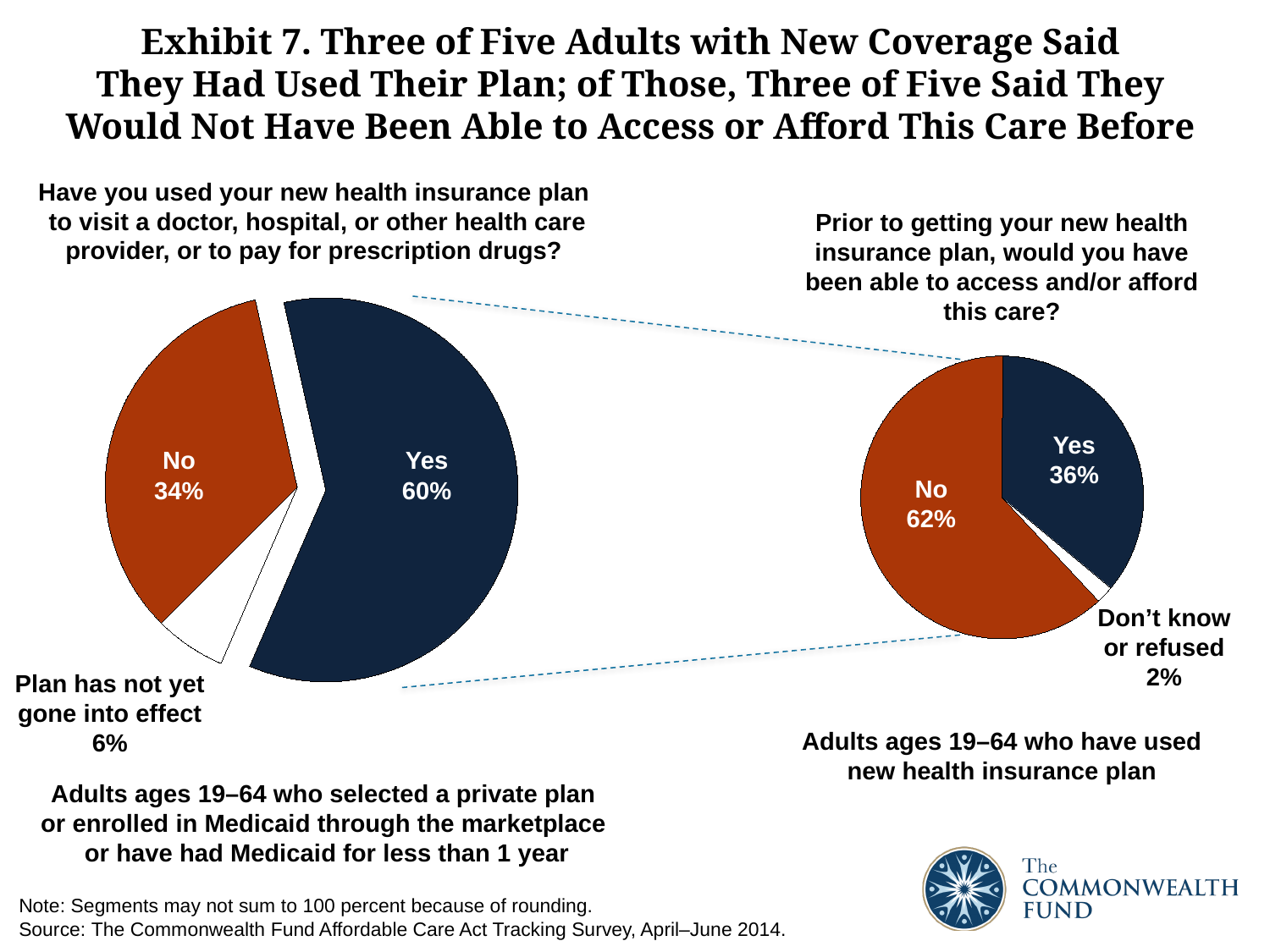
In the left pie chart (Have you used your new health insurance plan...), which segment is the smallest? Plan has not yet gone into effect In the right pie chart (Prior to getting your new health insurance plan...), which is larger, the Yes segment or the No segment? No In the left pie chart (Have you used your new health insurance plan...), what share of adults answered Yes? 60% In the right pie chart (Prior to getting your new health insurance plan...), what share answered Don't know or refused? 2% In the left pie chart (Have you used your new health insurance plan...), how many percentage points larger is the Yes segment than the No segment? 26 In the right pie chart (Prior to getting your new health insurance plan...), what share of adults answered No? 62% In the left pie chart (Have you used your new health insurance plan...), what share of adults answered No? 34% In the left pie chart (Have you used your new health insurance plan...), how many segments are there? 3 What type of chart is used on this slide? Pie chart In the left pie chart (Have you used your new health insurance plan...), what share said their plan has not yet gone into effect? 6% In the right pie chart (Prior to getting your new health insurance plan...), what share of adults answered Yes? 36% In the left pie chart (Have you used your new health insurance plan...), which segment is the largest? Yes